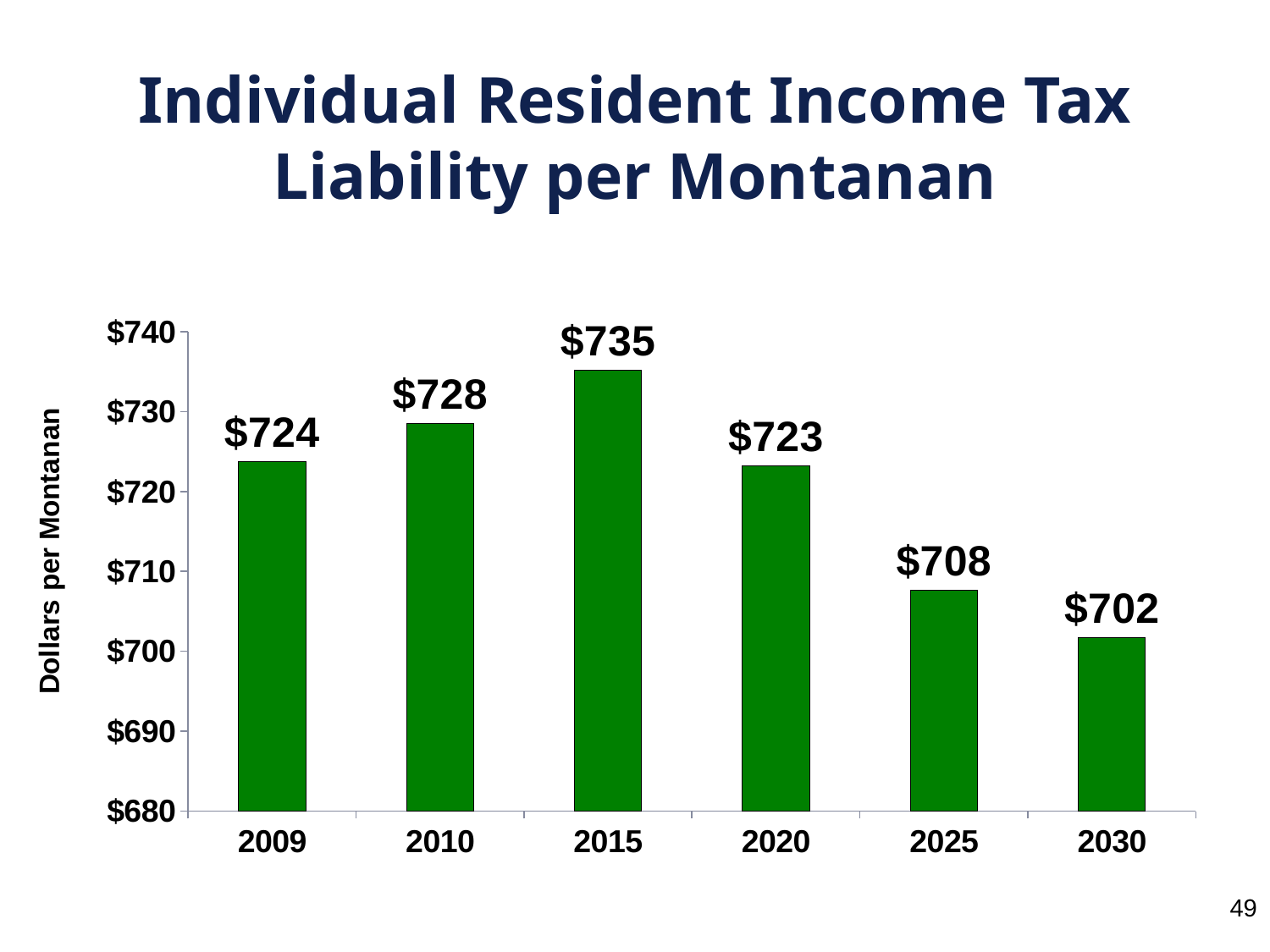
Which year has the highest income tax liability per Montanan? 2015 What is the income tax liability per Montanan in 2030? $702 What kind of chart is shown on the slide? bar chart What is the label on the vertical axis? Dollars per Montanan What is the value shown for 2009? $724 What is the income tax liability per Montanan in 2015? $735 Is the value for 2025 greater or less than $710? less Which is larger, the value for 2020 or the value for 2025? 2020 What is the difference between the 2015 value and the 2030 value? $33 What is the difference between the 2010 value and the 2009 value? $4 Which year has the lowest income tax liability per Montanan? 2030 How many years are shown on the x axis? 6